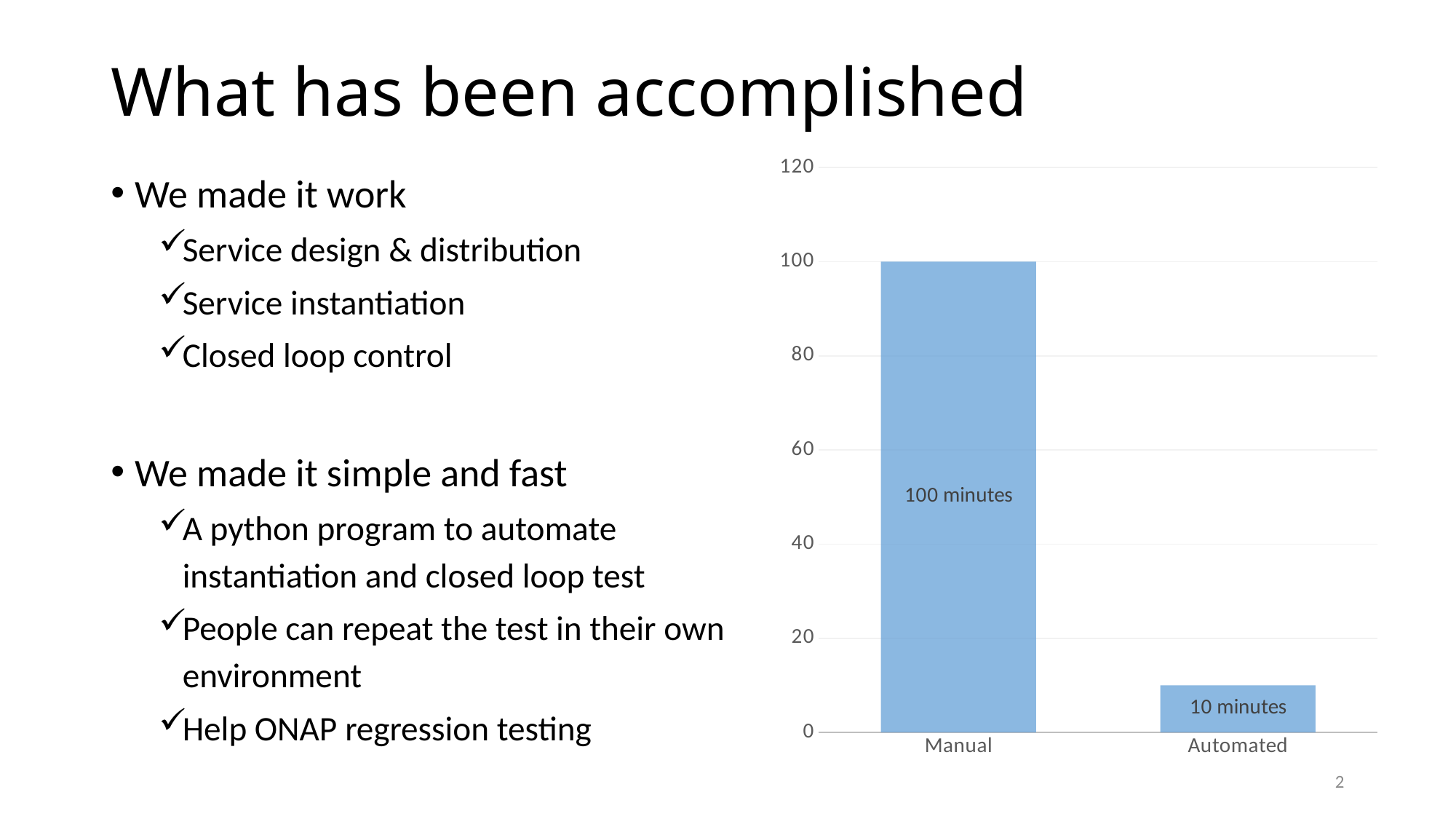
What is the highest tick value shown on the vertical axis? 120 What is the value for Manual? 100 minutes Do the values rise or fall from Manual to Automated? fall Is the value for Automated greater or less than 20? less Is the value for Manual greater or less than 80? greater Which category has the lowest value? Automated Which category has the highest value? Manual How many categories are shown on the x axis? 2 What is the value for Automated? 10 minutes Which is larger, the value for Manual or the value for Automated? Manual What kind of chart is shown on the slide? bar chart What is the difference between the Manual and Automated values? 90 minutes